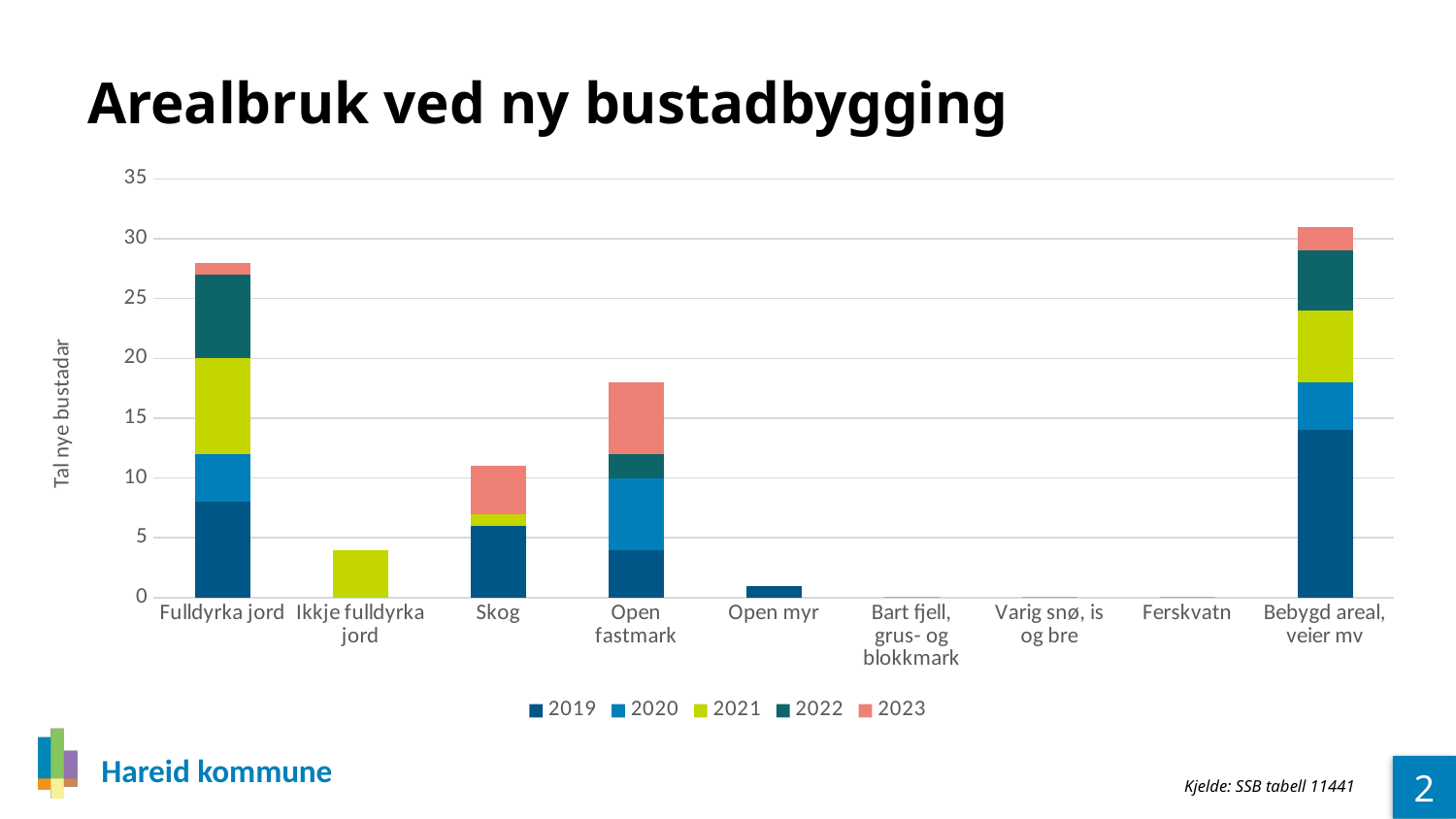
Which category has the tallest stacked bar? Bebygd areal, veier mv How many series does the legend list? 5 What is the label on the vertical axis? Tal nye bustadar Which has the larger total, Fulldyrka jord or Open fastmark? Fulldyrka jord Is the total value for Open fastmark greater or less than 20? less Which has the larger total, Skog or Open myr? Skog What is the title of the chart? Arealbruk ved ny bustadbygging Is the total value for Ikkje fulldyrka jord greater or less than 5? less How many categories are shown on the x axis? 9 Is the total value for Fulldyrka jord greater or less than 25? greater What kind of chart is shown on the slide? Stacked bar chart